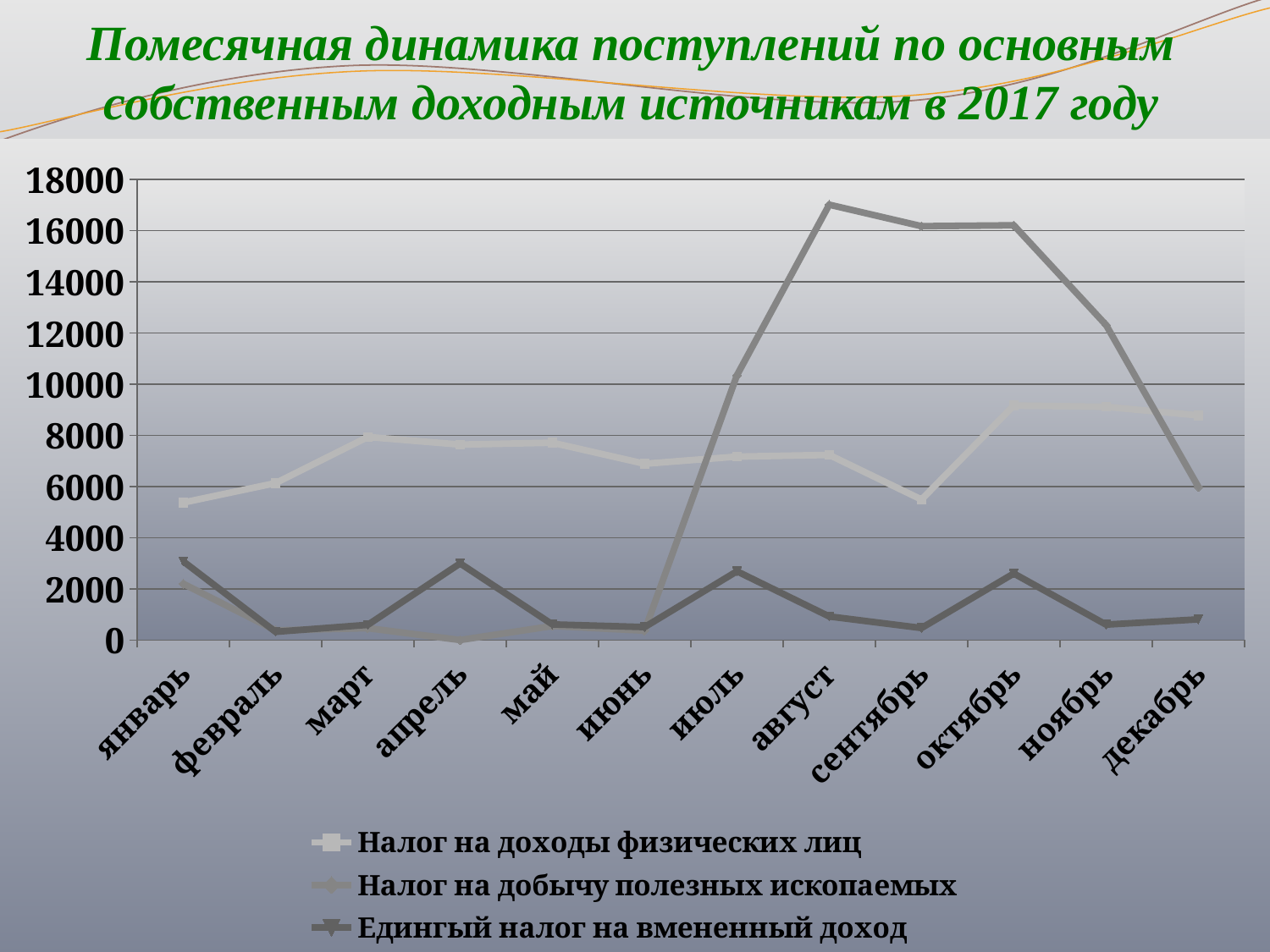
What kind of chart is shown on the slide? line chart In октябрь, which series has the larger value: 'Налог на добычу полезных ископаемых' or 'Налог на доходы физических лиц'? Налог на добычу полезных ископаемых Is the value for 'Единый налог на вмененный доход' in апрель greater or less than 4000? less In which month does the series 'Налог на добычу полезных ископаемых' reach its highest value? август In which month is the series 'Налог на добычу полезных ископаемых' at its lowest value? апрель How many months are shown on the x axis of the chart? 12 Is the value for 'Налог на доходы физических лиц' in январь greater or less than 6000? less In март, which series has the larger value: 'Налог на доходы физических лиц' or 'Налог на добычу полезных ископаемых'? Налог на доходы физических лиц How many series does the chart legend list? 3 Is the value for 'Налог на доходы физических лиц' in октябрь greater or less than 8000? greater Does the series 'Налог на добычу полезных ископаемых' rise or fall from октябрь to декабрь? fall